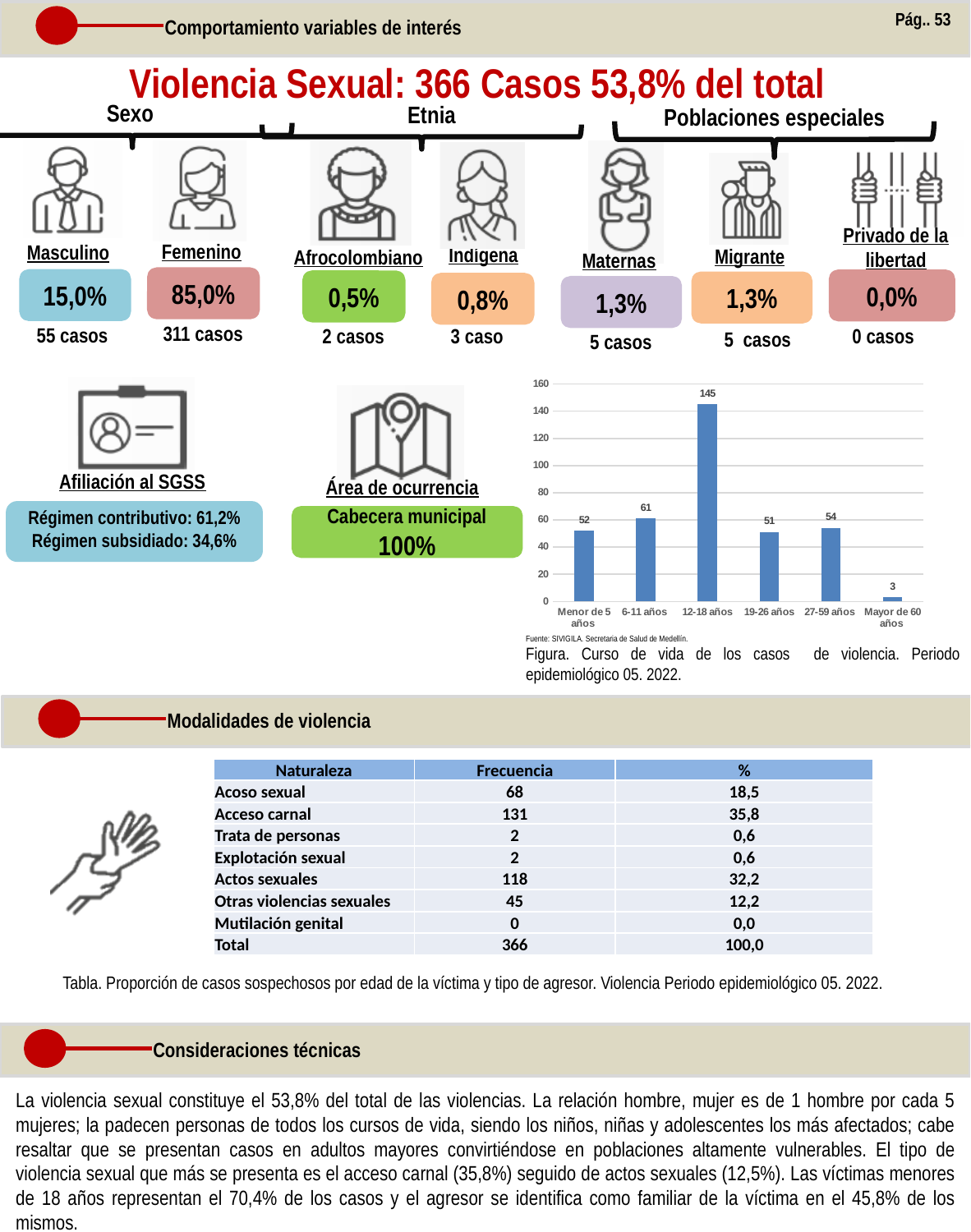
In the bar chart of cases by life course, what is the value for 27-59 años? 54 In the bar chart of cases by life course, which is larger: the value for 6-11 años or the value for 19-26 años? 6-11 años In the bar chart of cases by life course, which age group has the highest number of cases? 12-18 años What kind of chart is used to show cases by life course (Curso de vida)? Bar chart In the bar chart of cases by life course, what is the value for Menor de 5 años? 52 In the bar chart of cases by life course (Curso de vida), what is the value for the 12-18 años category? 145 What is the source cited below the bar chart of cases by life course? SIVIGILA. Secretaria de Salud de Medellín. In the bar chart of cases by life course, which age group has the lowest number of cases? Mayor de 60 años In the bar chart of cases by life course, what is the difference between the 12-18 años and 6-11 años values? 84 In the bar chart of cases by life course, is the value for 12-18 años greater or less than 140? greater In the bar chart of cases by life course, what is the difference between the 27-59 años and Mayor de 60 años values? 51 How many age-group categories are shown in the bar chart of cases by life course? 6